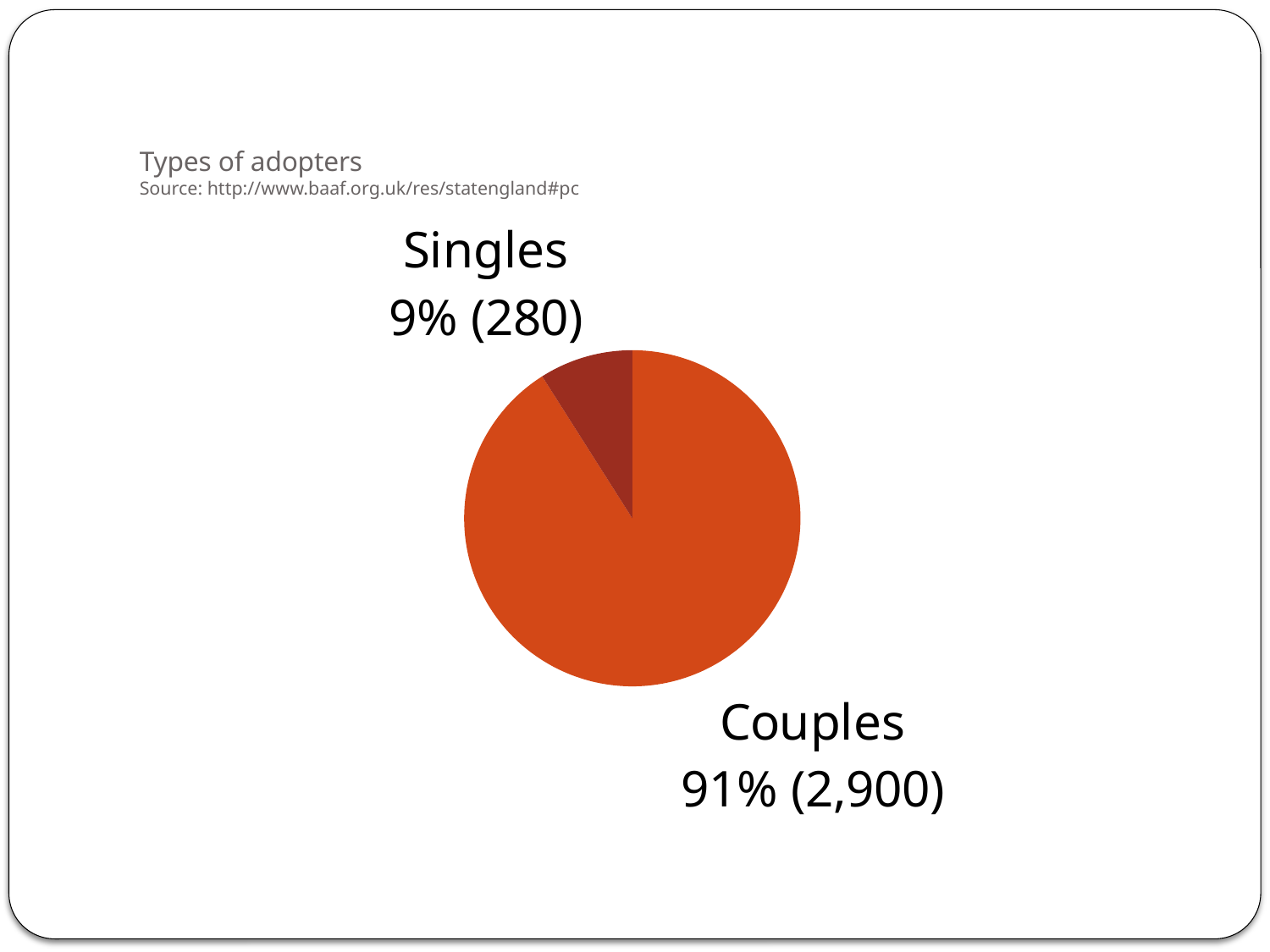
What share of the pie does the Singles slice represent? 9% What is the title of the chart? Types of adopters What kind of chart is shown on the slide? pie chart What share of the pie does the Couples slice represent? 91% What is the difference between the number of Couples adopters and the number of Singles adopters? 2,620 What is the number of adopters shown for Singles? 280 Which category has the largest slice of the pie? Couples Which category has the smallest slice of the pie? Singles How many slices does the pie chart have? 2 What is the difference in percentage points between the Couples share and the Singles share? 82 Which is larger, the share for Couples or the share for Singles? Couples What is the number of adopters shown for Couples? 2,900